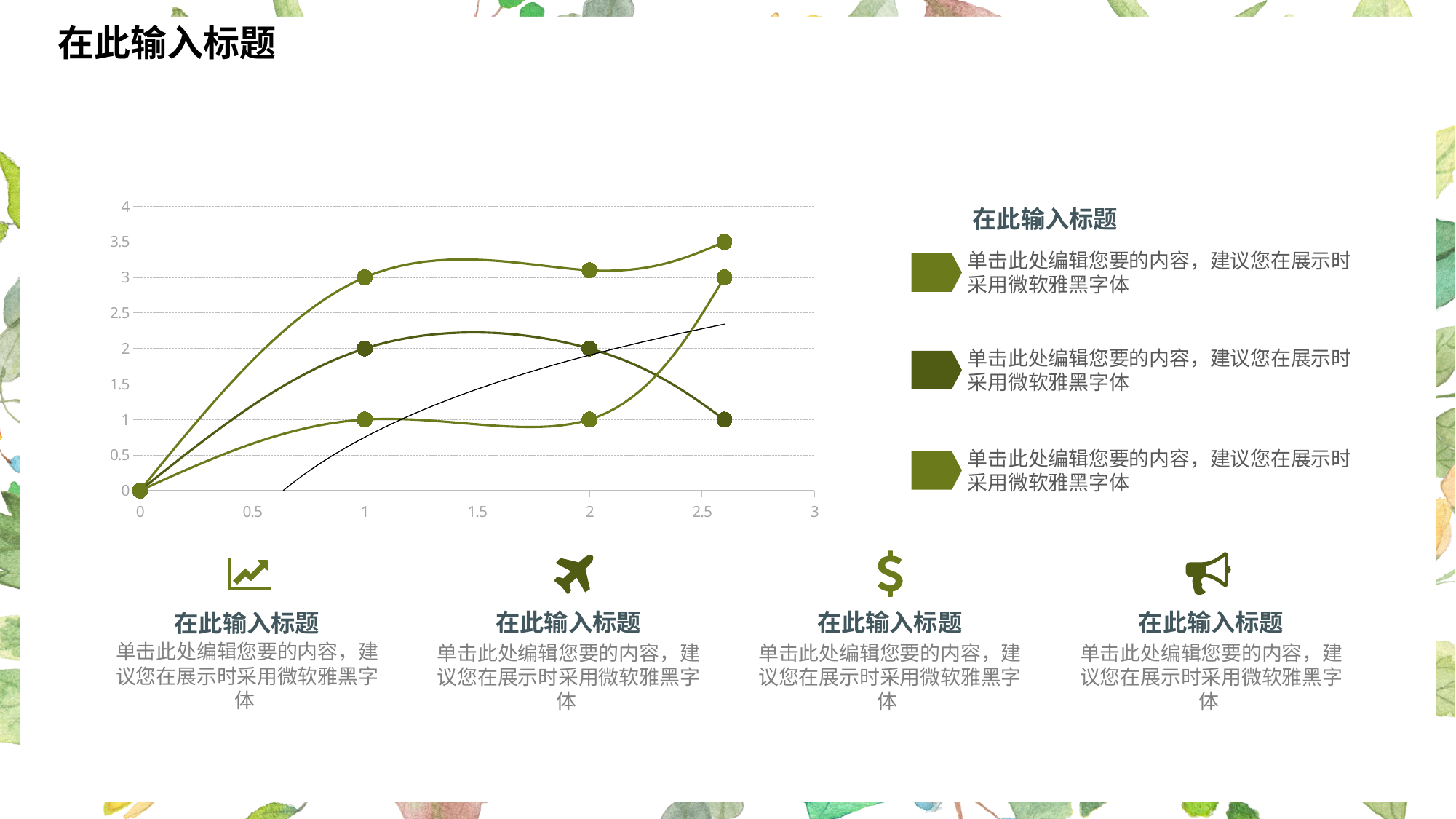
What is the y value of the highest plotted point at x = 1? 3 Is the y value of the highest plotted point at x = 2 greater or less than 2.5? greater What kind of chart is shown on the slide? scatter chart with smoothed lines What is the highest value shown on the vertical axis of the chart? 4 What is the y value of the middle plotted point at x = 2? 2 What is the y value of the middle plotted point at x = 1? 2 How many plotted points are there at x = 1? 3 What is the y value of the lowest plotted point at x = 1? 1 Is the y value of the highest plotted point on the chart greater or less than 3? greater What is the highest value shown on the horizontal axis of the chart? 3 What is the y value of the lowest plotted point at x = 2? 1 Does the topmost line rise or fall between x = 0 and x = 1? rise